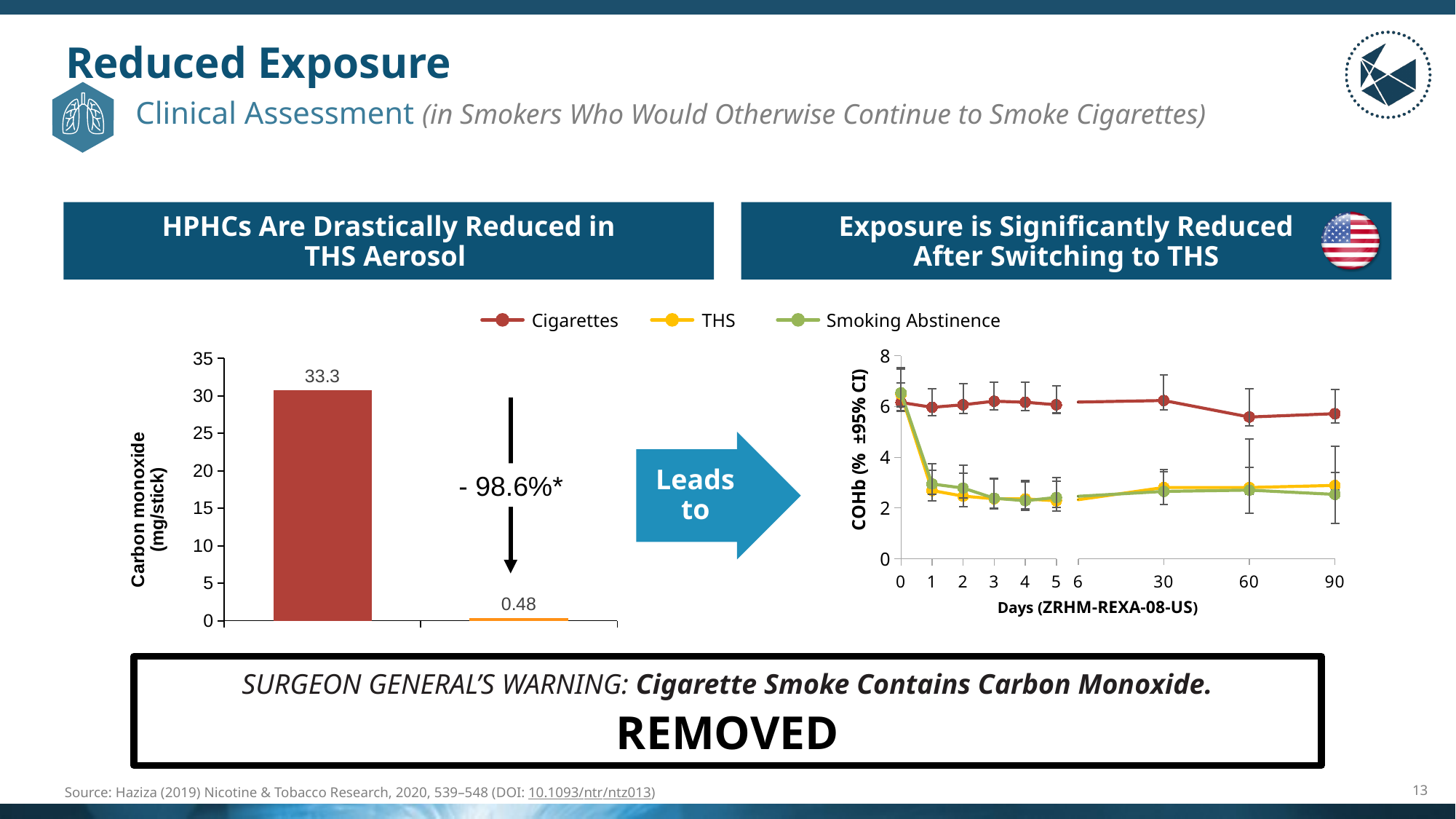
What kind of chart is the right chart under 'Exposure is Significantly Reduced After Switching to THS'? line chart In the left bar chart, which bar is higher, the red (Cigarettes) bar or the orange (THS) bar? the red (Cigarettes) bar What kind of chart is the left chart under 'HPHCs Are Drastically Reduced in THS Aerosol'? bar chart In the left bar chart, what percentage reduction is printed next to the downward arrow? - 98.6%* In the right line chart, which series has the highest COHb value at day 30, Cigarettes or THS? Cigarettes In the left bar chart, what is the carbon monoxide value shown on the red (Cigarettes) bar? 33.3 In the left bar chart, what is the difference between the red bar value and the orange bar value? 32.82 In the right line chart, is the COHb value for Cigarettes at day 0 greater or less than 4? greater In the right line chart, is the COHb value for THS at day 5 greater or less than 4? less How many series does the legend list for the right line chart? 3 In the left bar chart, what is the carbon monoxide value shown on the orange (THS) bar? 0.48 What is the y-axis label of the left bar chart? Carbon monoxide (mg/stick)